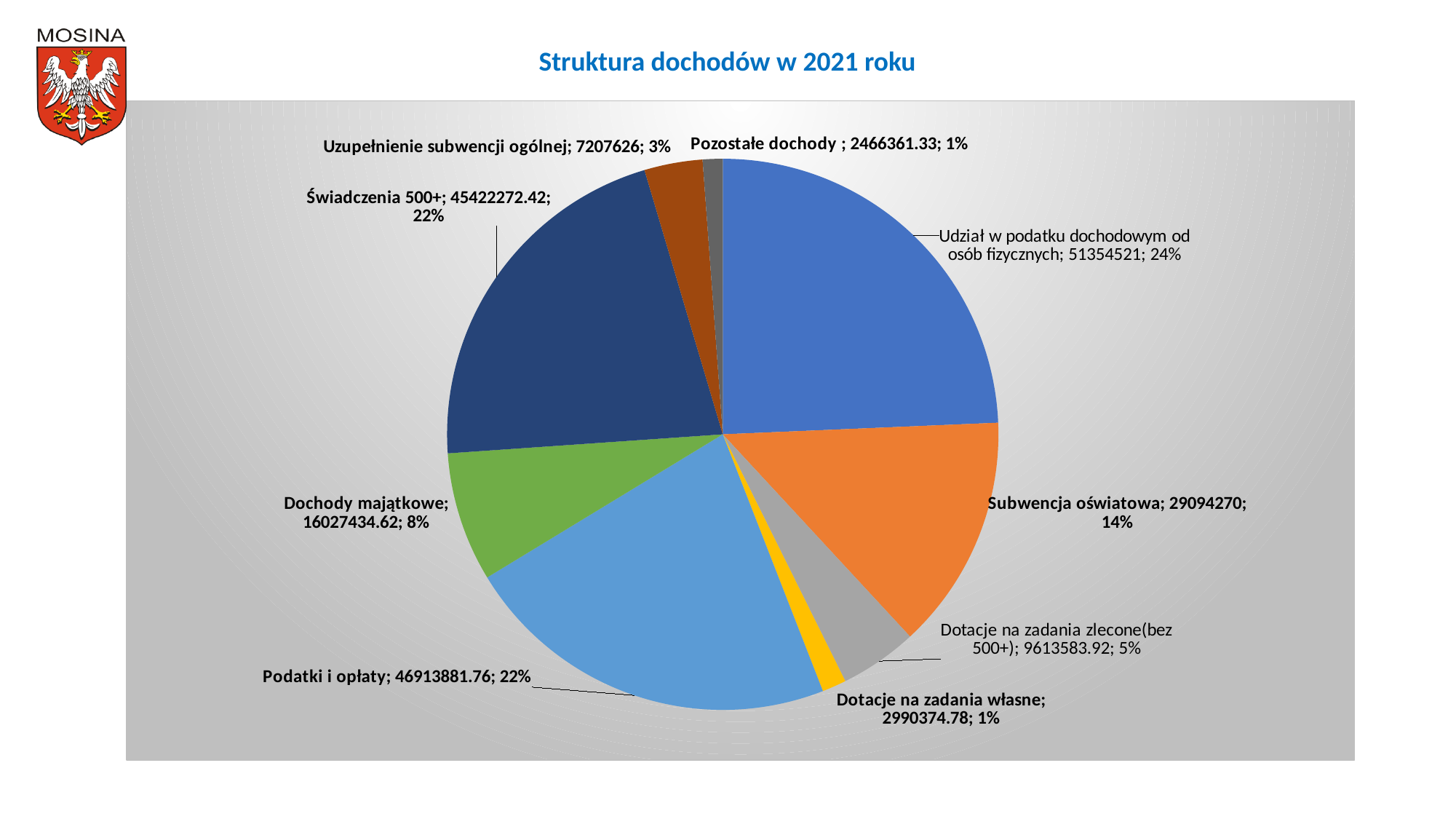
What is the difference between the value for Udział w podatku dochodowym od osób fizycznych and the value for Podatki i opłaty? 4440639.24 What share of the pie does Uzupełnienie subwencji ogólnej represent? 3% What is the value for Dotacje na zadania zlecone(bez 500+)? 9613583.92 How many slices does the pie chart have? 9 Which is larger, the value for Podatki i opłaty or the value for Świadczenia 500+? Podatki i opłaty What is the title of the chart? Struktura dochodów w 2021 roku What share of the pie does Świadczenia 500+ represent? 22% Which category has the smallest slice of the pie? Pozostałe dochody Which category has the largest slice of the pie? Udział w podatku dochodowym od osób fizycznych What is the value for Dochody majątkowe? 16027434.62 What is the value for Subwencja oświatowa? 29094270 What kind of chart is shown on the slide? pie chart